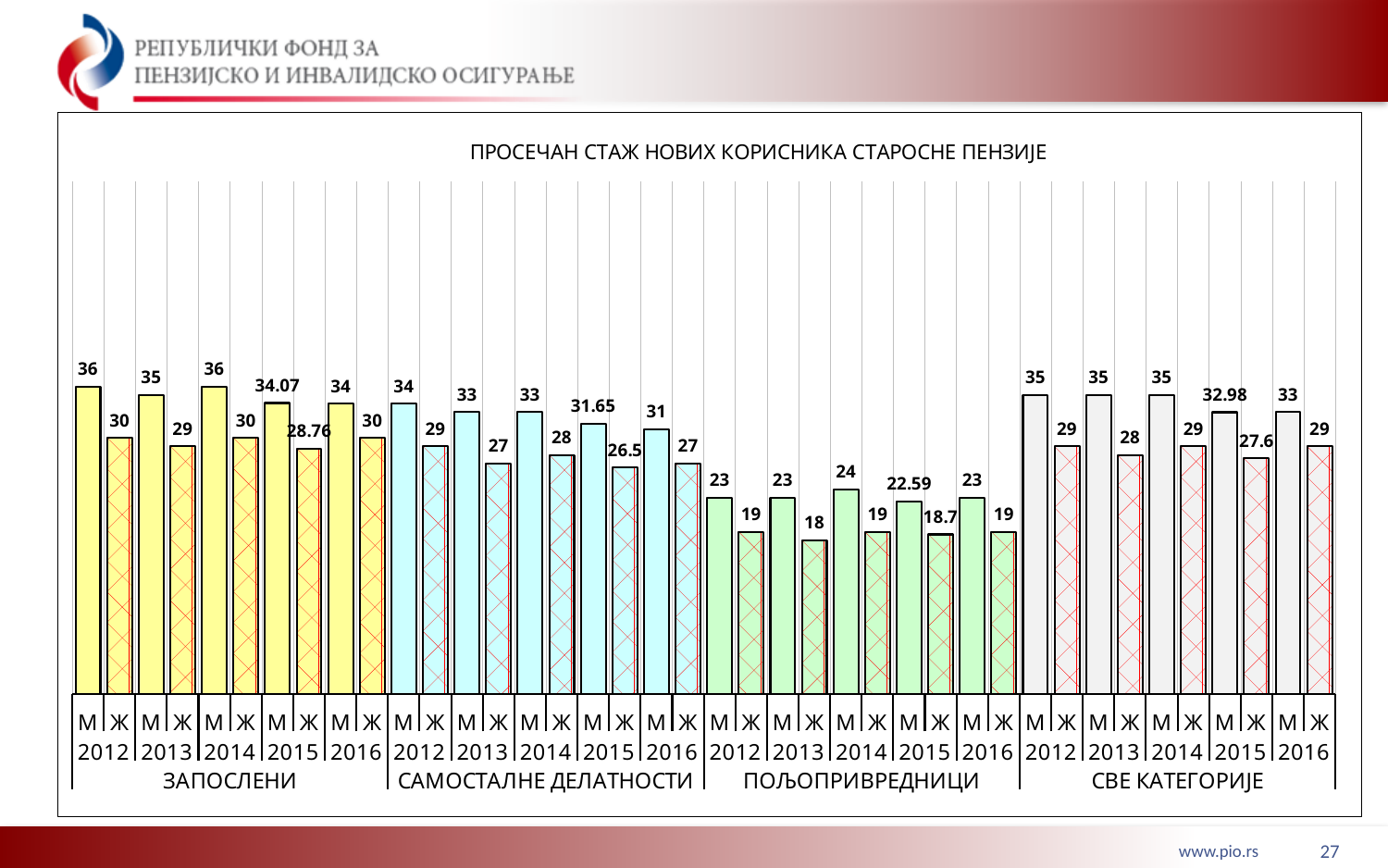
What kind of chart is shown on the slide? Bar chart How many category groups are shown along the x axis of the chart? 4 What is the difference between the М values for 2012 and 2016 in the САМОСТАЛНЕ ДЕЛАТНОСТИ group? 3 What is the difference between the М and Ж values for 2012 in the ЗАПОСЛЕНИ group? 6 What is the title of the chart? ПРОСЕЧАН СТАЖ НОВИХ КОРИСНИКА СТАРОСНЕ ПЕНЗИЈЕ What is the value for М (men) in 2012 in the ЗАПОСЛЕНИ group? 36 What is the value for Ж (women) in 2015 in the ЗАПОСЛЕНИ group? 28.76 Which is larger: the М value for 2014 in ПОЉОПРИВРЕДНИЦИ or the Ж value for 2014 in САМОСТАЛНЕ ДЕЛАТНОСТИ? Ж 2014 in САМОСТАЛНЕ ДЕЛАТНОСТИ (28) What is the value for М in 2015 in the СВЕ КАТЕГОРИЈЕ group? 32.98 What is the value for М in 2015 in the САМОСТАЛНЕ ДЕЛАТНОСТИ group? 31.65 Which bar has the lowest value on the chart? Ж 2013, ПОЉОПРИВРЕДНИЦИ (18) What is the value for Ж in 2015 in the ПОЉОПРИВРЕДНИЦИ group? 18.7